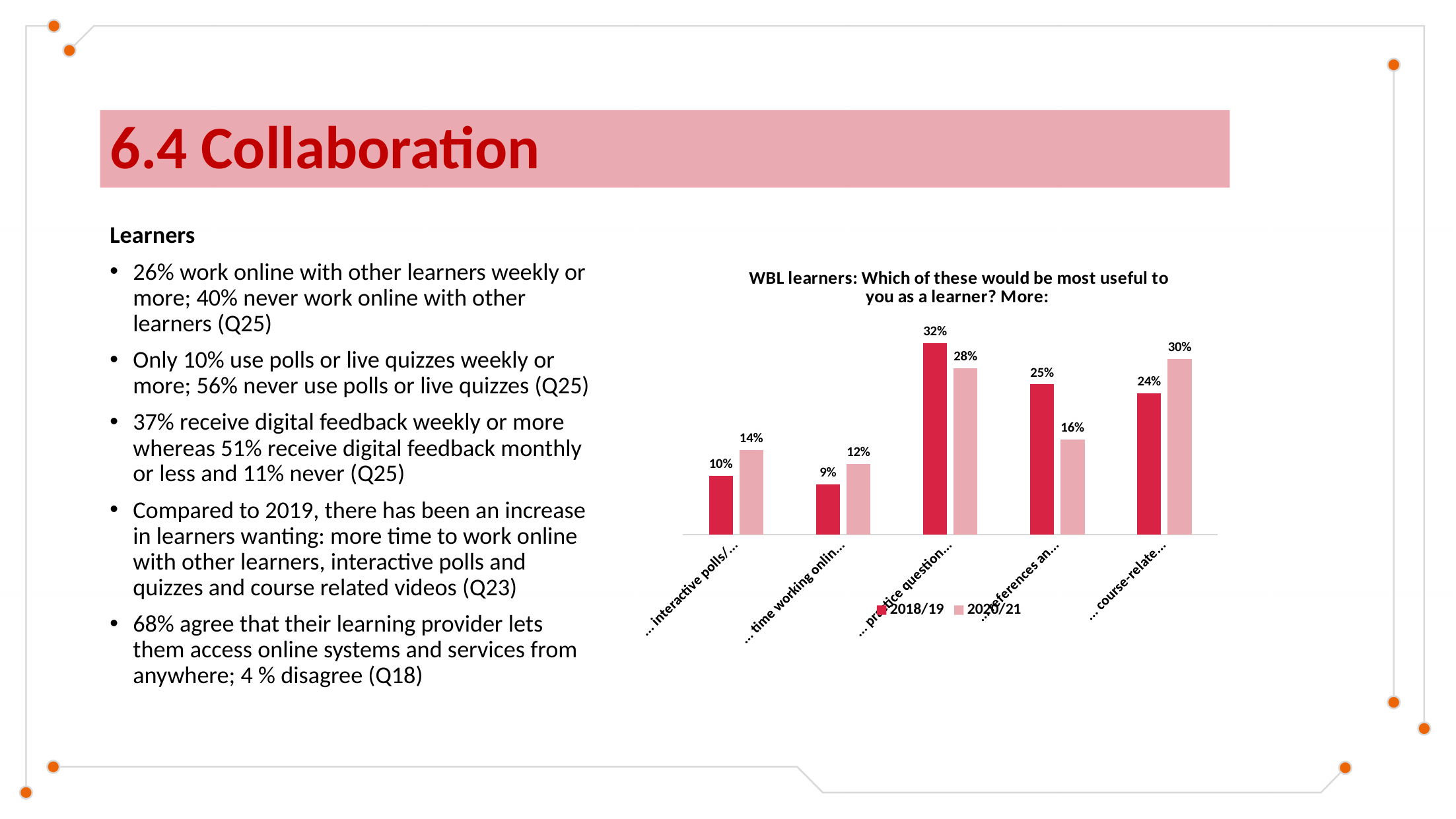
Which category has the lowest 2020/21 value? ... time working onlin... For the 'course-relate...' category, which series has the larger value, 2018/19 or 2020/21? 2020/21 What is the 2020/21 value for the 'interactive polls/...' category? 14% What are the two series named in the chart legend? 2018/19 and 2020/21 What is the difference between the 2018/19 and 2020/21 values for the 'references an...' category? 9% What is the 2018/19 value for the 'time working onlin...' category? 9% What type of chart is shown on the slide? Bar chart How many series does the chart legend list? 2 What is the 2020/21 value for the 'course-relate...' category? 30% How many categories are shown on the x axis of the chart? 5 Which category has the highest 2018/19 value? ... practice question... What is the 2018/19 value for the 'practice question...' category? 32%